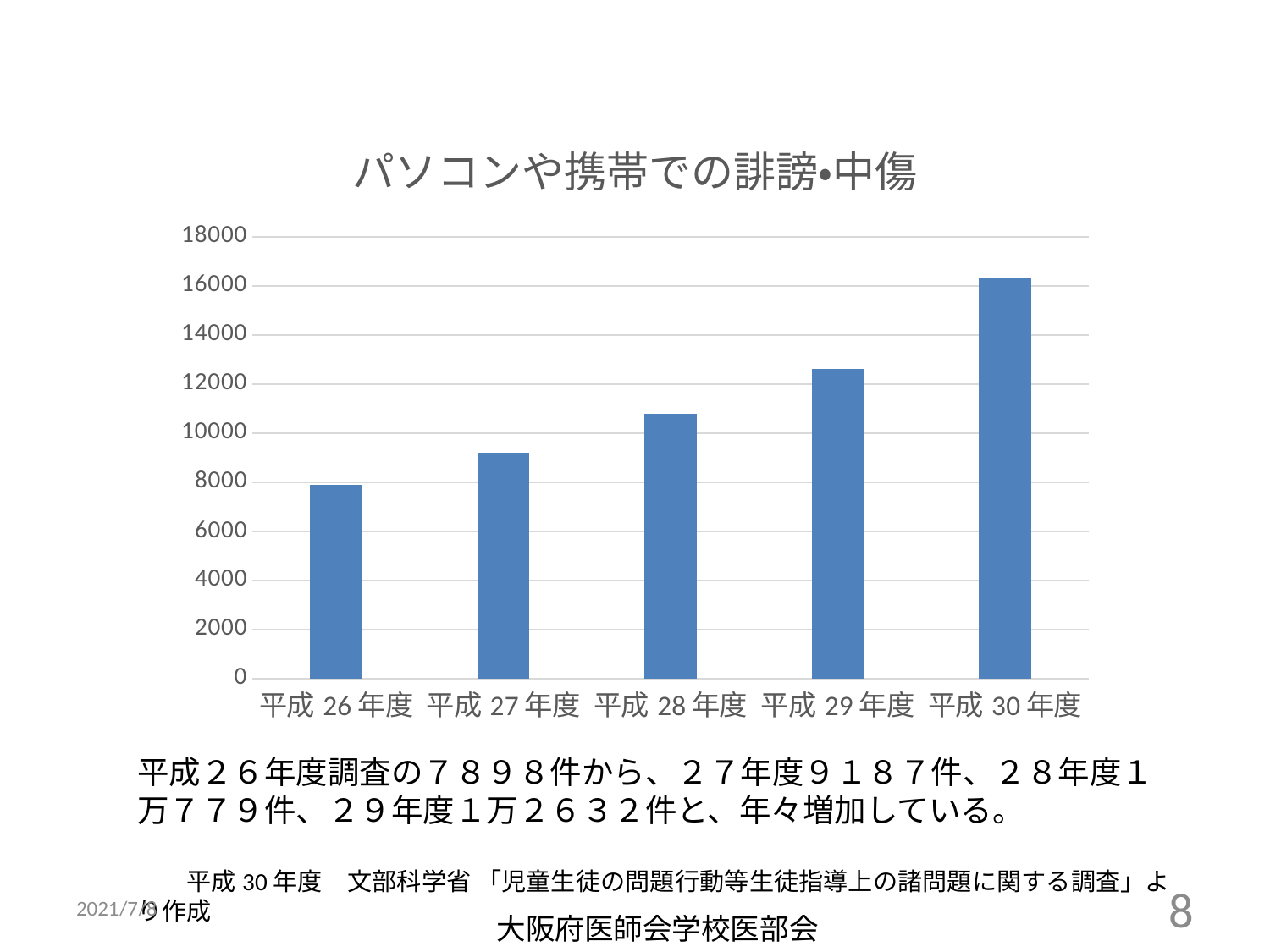
What is the maximum value shown on the vertical axis? 18000 Is the value for 平成26年度 greater or less than 8000? less Is the value for 平成29年度 greater or less than 14000? less Is the value for 平成30年度 greater or less than 16000? greater What is the title of the chart? パソコンや携帯での誹謗•中傷 Which fiscal year has the lowest bar? 平成26年度 What kind of chart is shown on the slide? bar chart How many categories (fiscal years) are shown on the x axis? 5 Which fiscal year has the highest bar? 平成30年度 Do the values rise or fall from 平成26年度 to 平成30年度? rise Which is larger, the value for 平成27年度 or the value for 平成29年度? 平成29年度